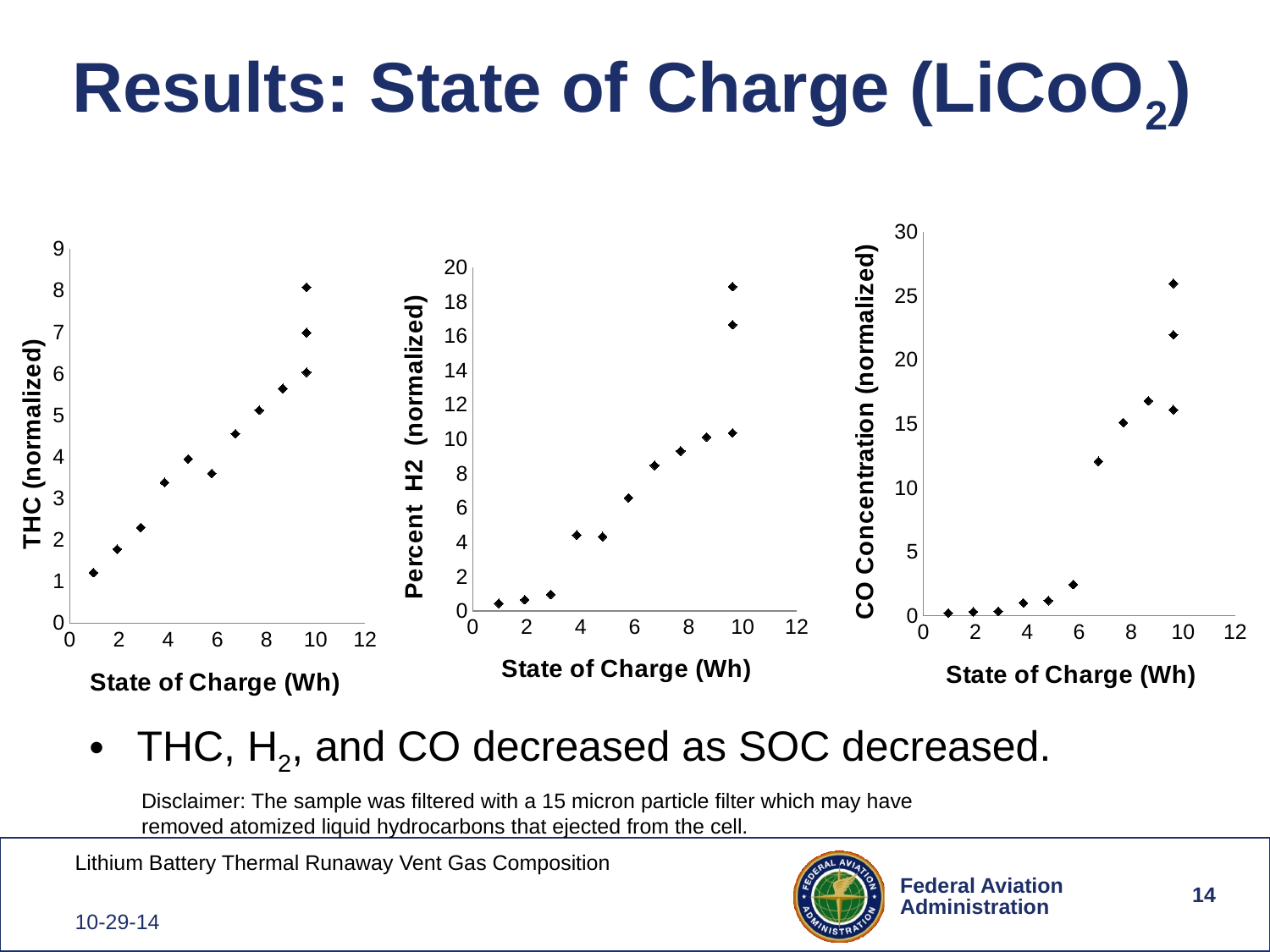
In the left chart (THC (normalized)), is the highest plotted value greater or less than 7? greater In the middle chart (Percent H2 (normalized)), is the highest plotted value greater or less than 16? greater In the left chart (THC (normalized)), is the value at a State of Charge of about 1 Wh greater or less than 2? less What is the x-axis title of the middle chart? State of Charge (Wh) In the middle chart (Percent H2 (normalized)), do the values rise or fall as State of Charge increases? rise What kind of chart is the left chart (THC (normalized))? scatter chart In the left chart (THC (normalized)), do the values rise or fall as State of Charge increases? rise What is the y-axis title of the right chart? CO Concentration (normalized) In the right chart (CO Concentration (normalized)), do the values rise or fall as State of Charge increases? rise